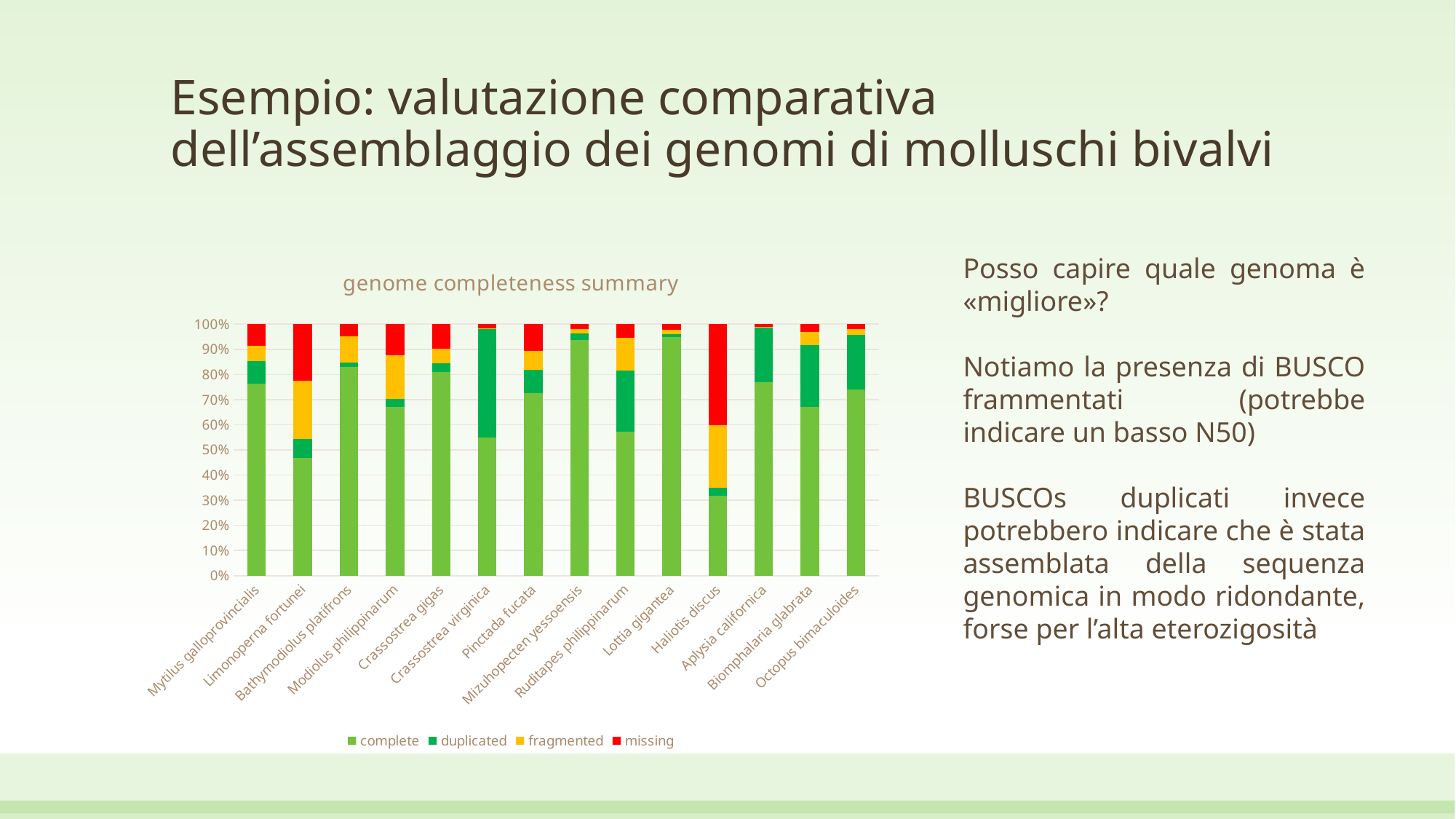
How many species (categories) are plotted along the x axis of the chart? 14 Which has the larger 'complete' share, Bathymodiolus platifrons or Modiolus philippinarum? Bathymodiolus platifrons Is the 'complete' share for Haliotis discus greater or less than 40%? less Which species has the largest 'missing' share in the chart? Haliotis discus Which species has the lowest 'complete' share in the chart? Haliotis discus What is the total height of the stacked bar for Mytilus galloprovincialis? 100% Is the 'complete' share for Lottia gigantea greater or less than 90%? greater What is the title of the chart on the slide? genome completeness summary What kind of chart is shown on the slide? stacked bar chart Which species has the largest 'duplicated' share in the chart? Crassostrea virginica How many series does the chart legend list? 4 Which series in the chart is shown in red? missing